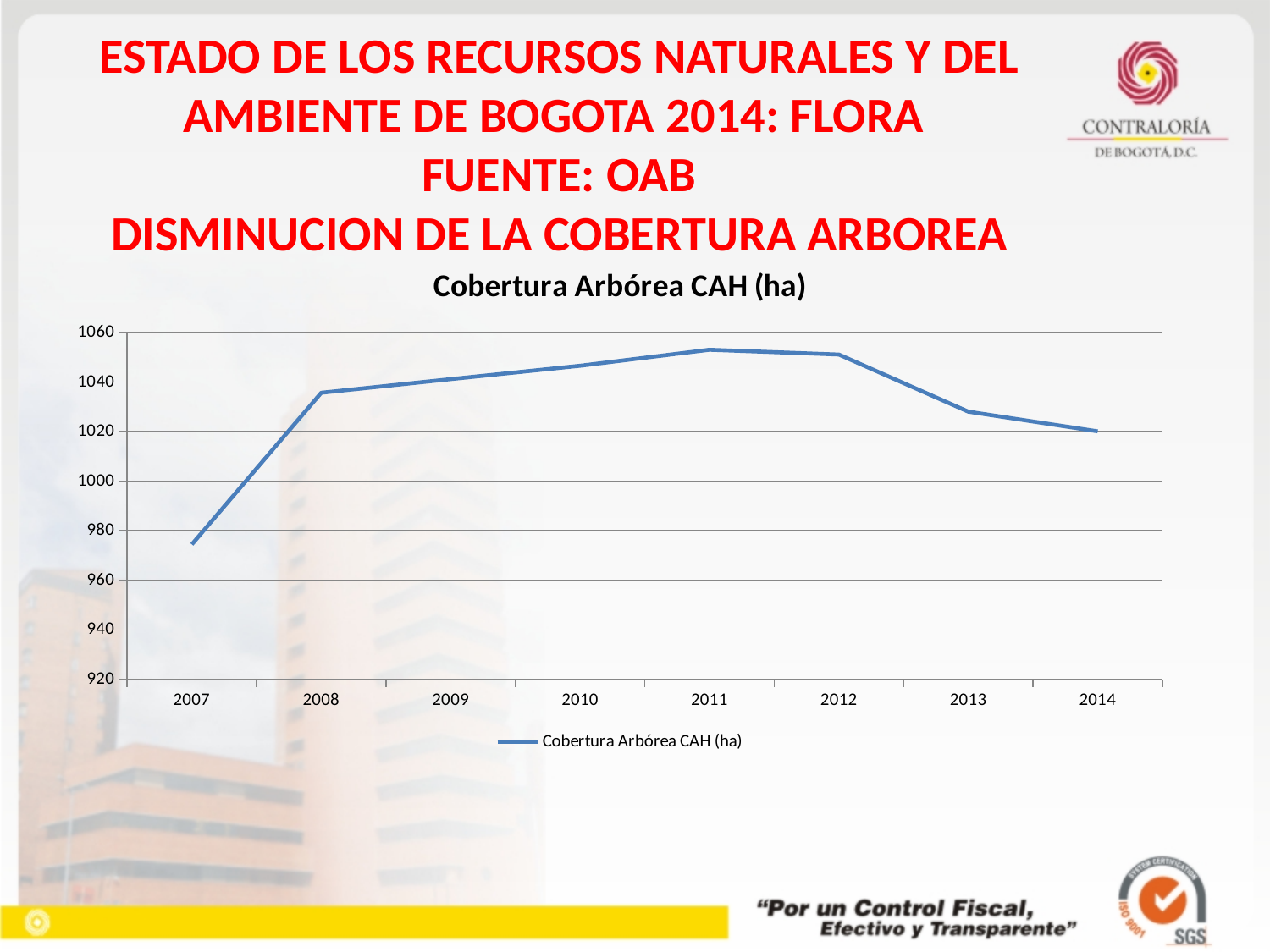
Is the value for 2007 greater or less than 980? less What is the title of the chart? Cobertura Arbórea CAH (ha) Do the values rise or fall from 2012 to 2014? Fall How many series does the legend list? 1 How many years are plotted on the x axis? 8 What kind of chart is shown on the slide? Line chart Which year has the lowest value for Cobertura Arbórea CAH (ha)? 2007 Is the value for 2008 greater or less than 1020? greater Which year has the larger value, 2007 or 2008? 2008 Is the value for 2012 greater or less than 1040? greater Which year has the larger value, 2011 or 2013? 2011